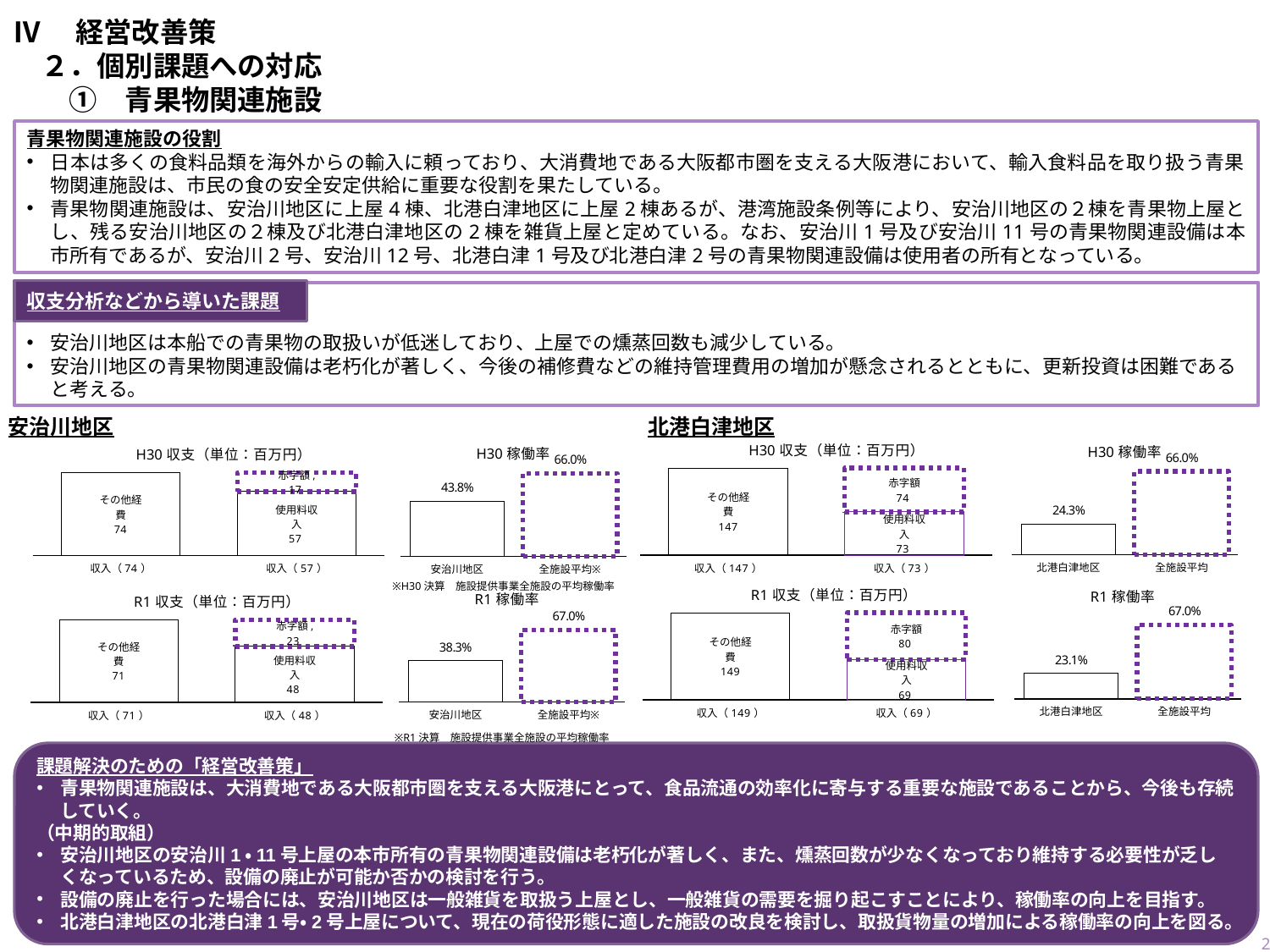
北港白津地区の「H30 収支」のグラフで、その他経費の値はいくらですか？ 147 北港白津地区の「R1 稼働率」のグラフで、北港白津地区と全施設平均の稼働率の差はいくらですか？ 43.9% 北港白津地区の「H30 稼働率」のグラフは、どの種類のグラフですか？ 棒グラフ 安治川地区の「H30 稼働率」のグラフで、安治川地区の稼働率はいくらですか？ 43.8% 安治川地区の「H30 収支」のグラフの単位は何ですか？ 百万円 安治川地区の「H30 収支」のグラフで、使用料収入の値はいくらですか？ 57 安治川地区の「R1 稼働率」のグラフで、全施設平均の稼働率はいくらですか？ 67.0% 安治川地区の「R1 収支」のグラフで、赤字額はいくらですか？ 23 北港白津地区の「R1 収支」のグラフで、使用料収入と赤字額を合計した棒の値はいくらですか？ 149 安治川地区の「H30 収支」のグラフで、その他経費と使用料収入の差はいくらですか？ 17 北港白津地区の「H30 稼働率」のグラフで、北港白津地区の稼働率はいくらですか？ 24.3% 安治川地区の「R1 稼働率」のグラフで、安治川地区と全施設平均のどちらの稼働率が高いですか？ 全施設平均